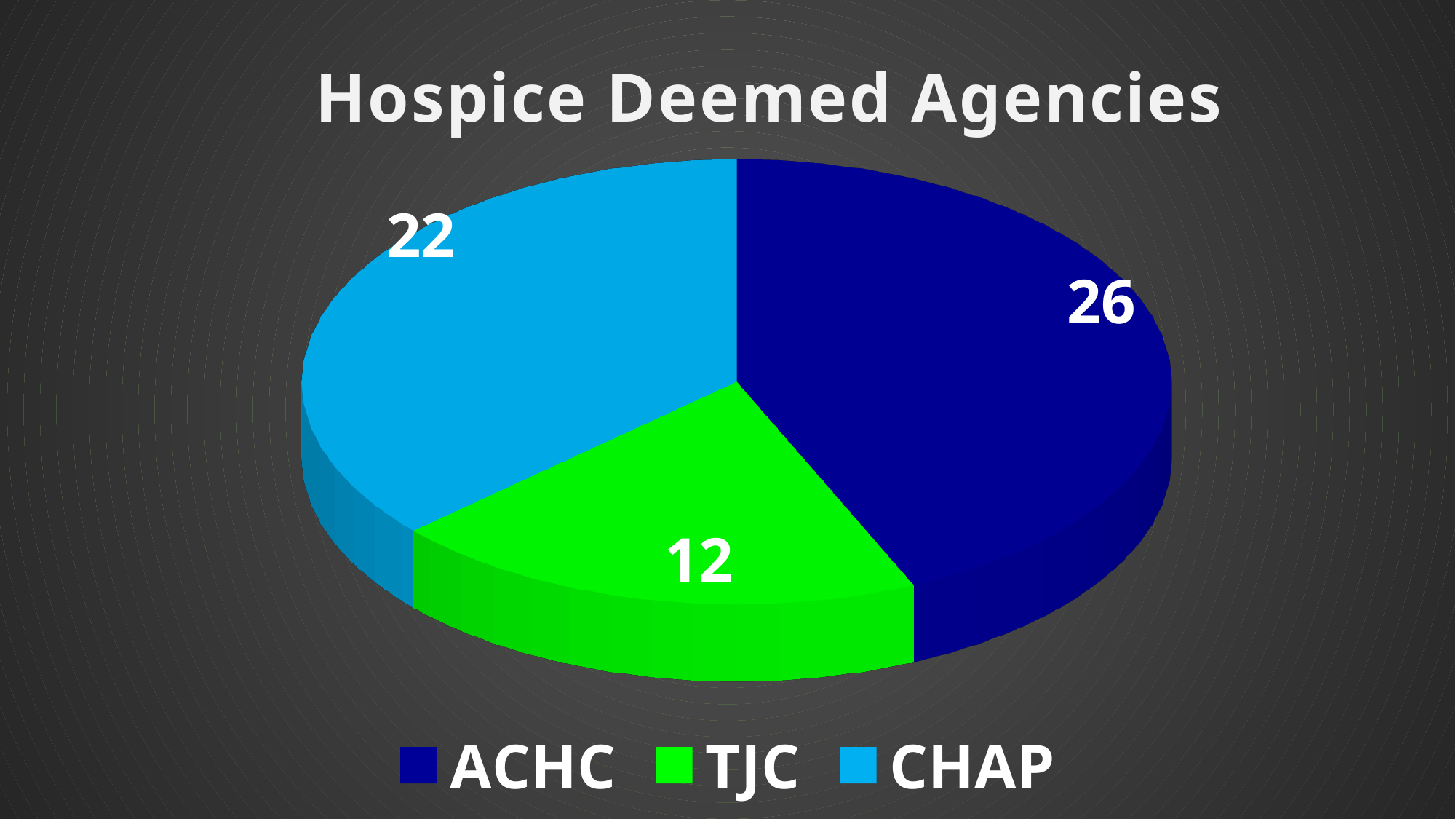
Which agency has the smallest slice? TJC What is the value for TJC? 12 What is the difference between the values for ACHC and CHAP? 4 What share of the total does TJC represent? 20% What is the value for CHAP? 22 Which agency has the largest slice? ACHC What kind of chart is shown on the slide? Pie chart Which is larger, the value for CHAP or the value for TJC? CHAP How many slices does the pie chart have? 3 What is the difference between the values for ACHC and TJC? 14 What is the value for ACHC? 26 What is the title of the chart? Hospice Deemed Agencies